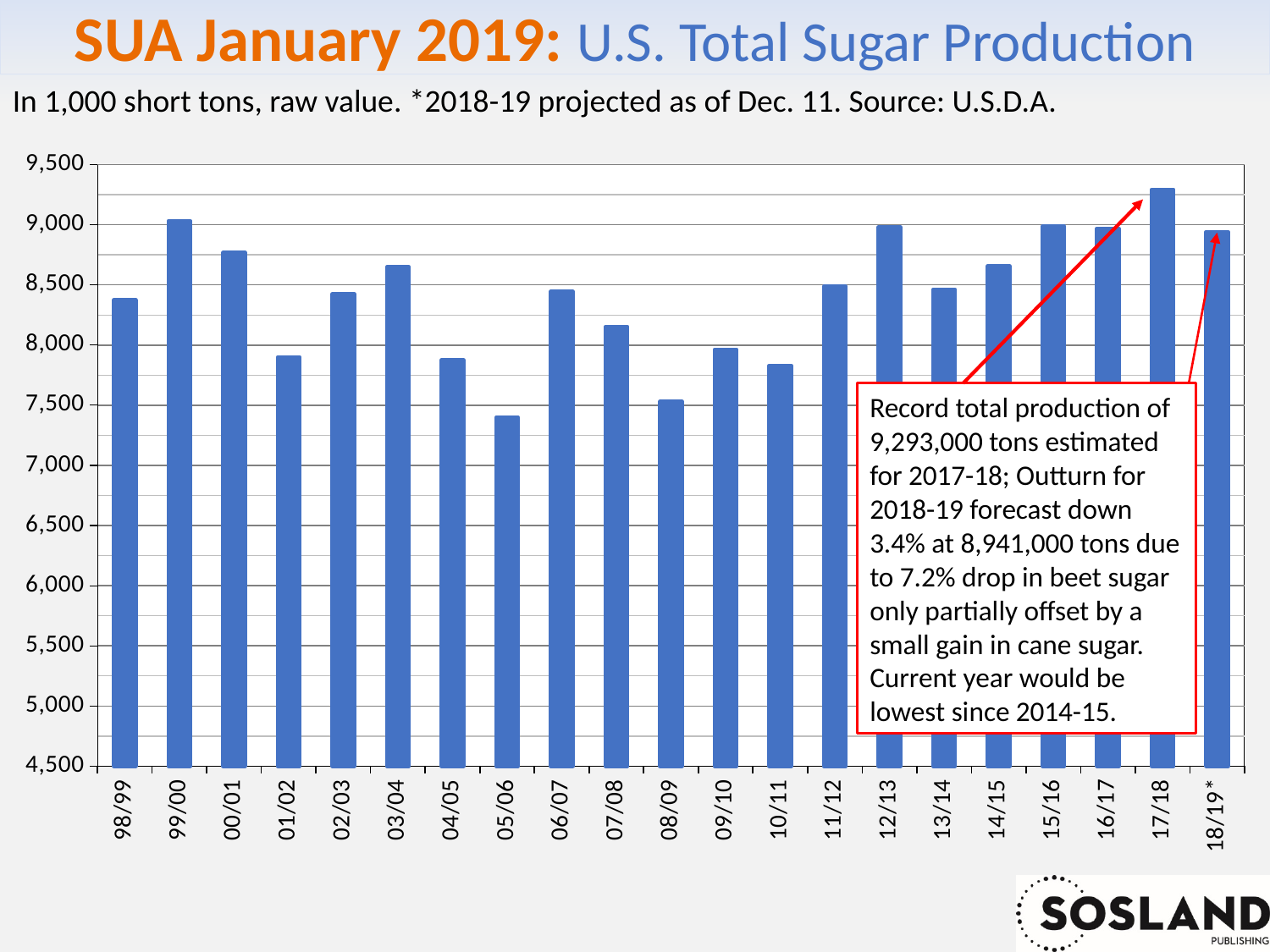
Is the value for 03/04 greater or less than 8,500? greater Which crop year has the lowest U.S. total sugar production in the chart? 05/06 Is the value for 05/06 greater or less than 7,500? less What kind of chart is shown on the slide? bar chart How many crop years are shown on the x axis of the chart? 21 Is the value for 10/11 greater or less than 8,000? less According to the annotation on the chart, what is the record total production estimated for 2017-18? 9,293,000 tons Which crop year has the larger value, 99/00 or 00/01? 99/00 Which crop year has the highest U.S. total sugar production in the chart? 17/18 Which crop year has the larger value, 12/13 or 13/14? 12/13